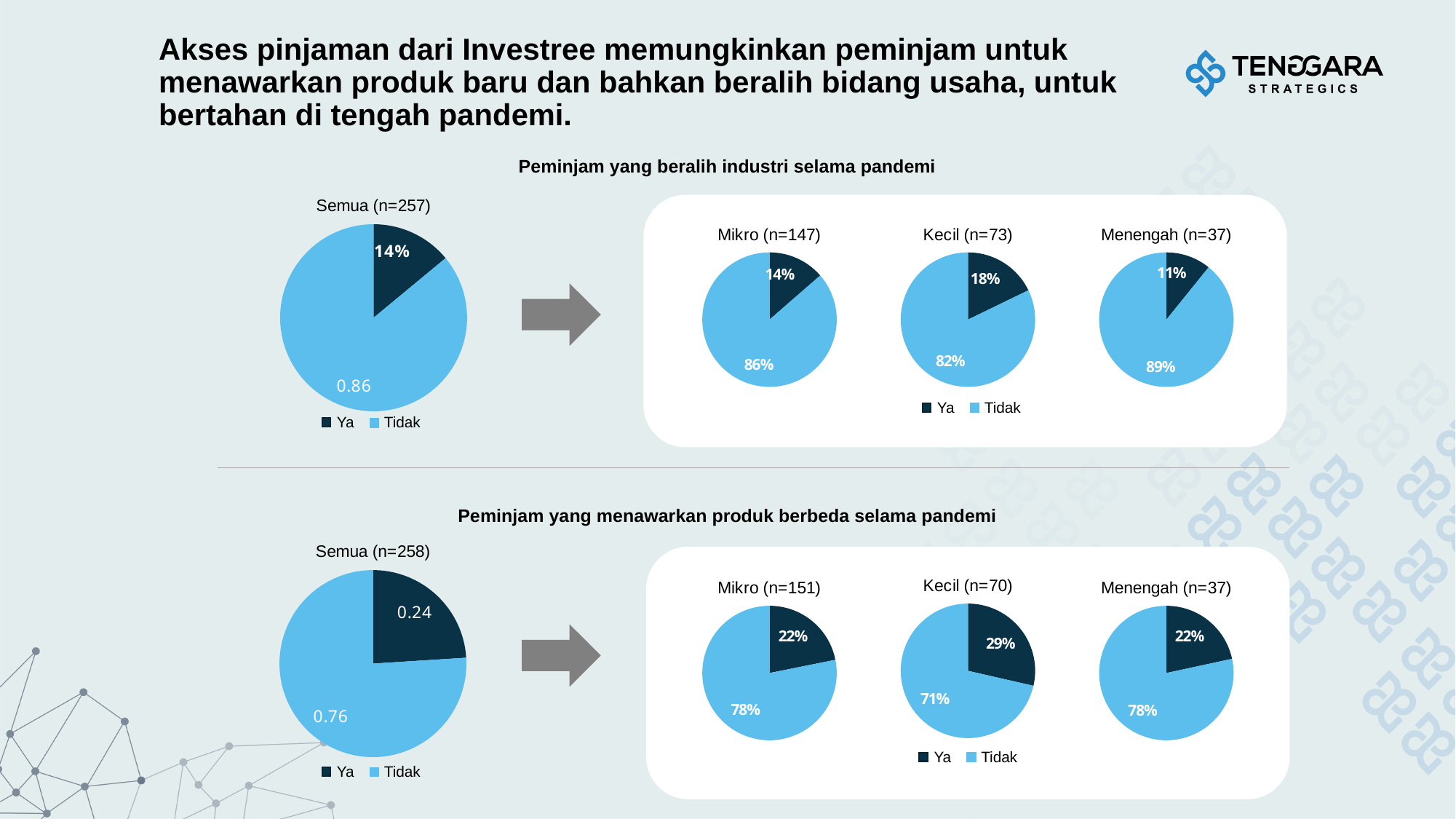
In the 'Peminjam yang beralih industri selama pandemi' section, is the 'Ya' share larger for Kecil (n=73) or for Menengah (n=37)? Kecil (n=73) In the 'Peminjam yang beralih industri selama pandemi' section, what value is shown for the 'Tidak' slice in the Semua (n=257) pie chart? 0.86 In the 'Peminjam yang menawarkan produk berbeda selama pandemi' section, what is the 'Ya' share in the Kecil (n=70) pie chart? 29% In the 'Peminjam yang menawarkan produk berbeda selama pandemi' section, what is the difference between the 'Ya' share for Kecil (n=70) and the 'Ya' share for Mikro (n=151)? 7% In the 'Peminjam yang beralih industri selama pandemi' section, which of the three subgroup pie charts (Mikro, Kecil, Menengah) has the highest 'Ya' share? Kecil (n=73) What type of chart is used throughout this slide? Pie chart How many entries does the legend list for the pie charts on this slide? 2 In the 'Peminjam yang menawarkan produk berbeda selama pandemi' section, what value is shown for the 'Ya' slice in the Semua (n=258) pie chart? 0.24 In the 'Peminjam yang menawarkan produk berbeda selama pandemi' section, what is the 'Tidak' share in the Mikro (n=151) pie chart? 78% In the 'Peminjam yang beralih industri selama pandemi' section, what is the 'Tidak' share in the Kecil (n=73) pie chart? 82% In the 'Peminjam yang beralih industri selama pandemi' section, what is the 'Ya' share in the Mikro (n=147) pie chart? 14% In the 'Peminjam yang beralih industri selama pandemi' section, what is the 'Ya' share in the Menengah (n=37) pie chart? 11%